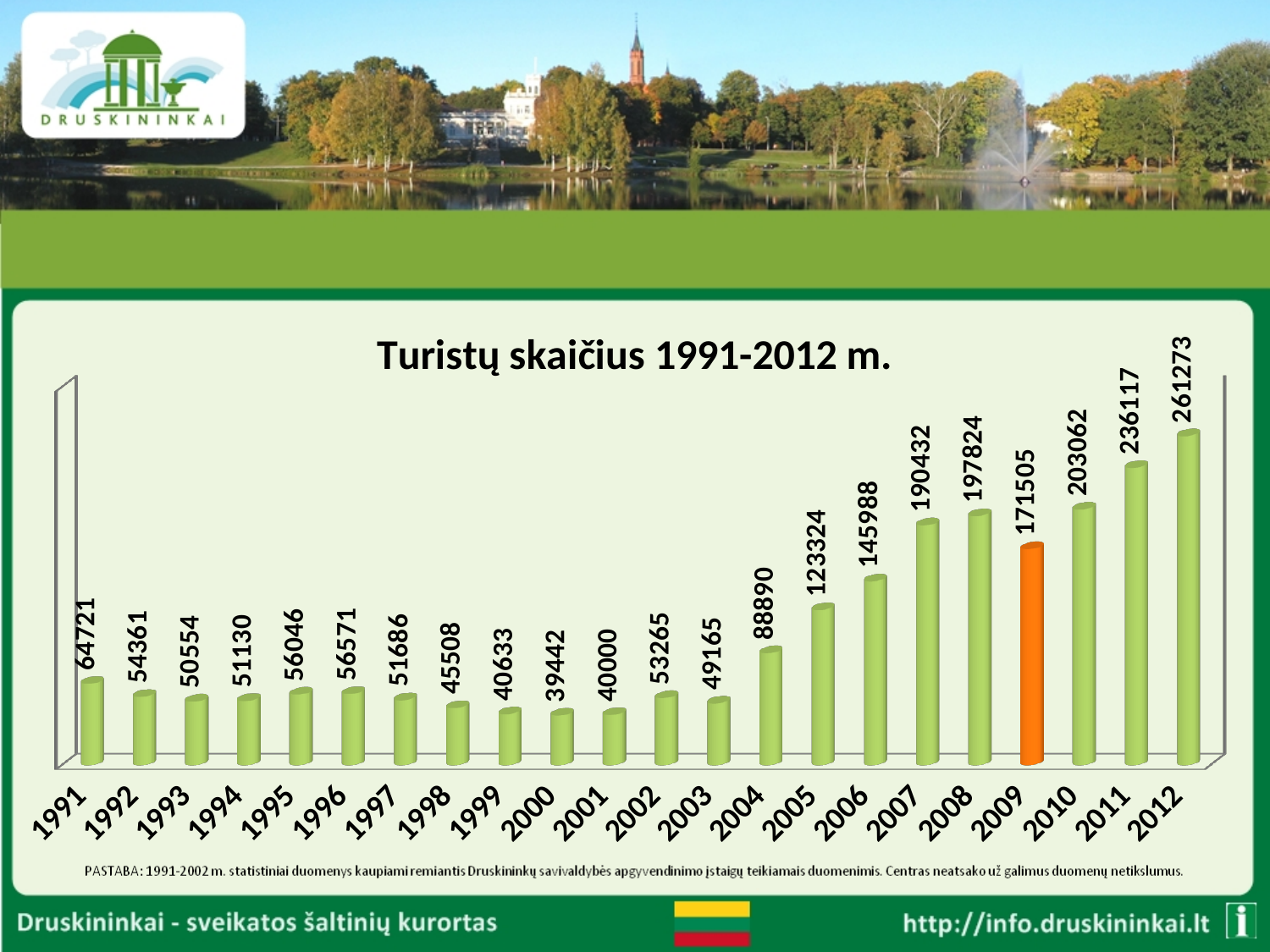
What is the difference between the values for 2008 and 2009? 26319 What is the value for 2009? 171505 Which year has the highest value? 2012 Which is larger, the value for 2007 or the value for 2010? 2010 Which bar is coloured differently (orange) from the others? 2009 What kind of chart is shown on the slide? bar chart What is the difference between the values for 2012 and 2011? 25156 Which year has the lowest value? 2000 What is the value for 1991? 64721 How many years (bars) are plotted in the chart? 22 What is the value for 2005? 123324 What is the title of the chart? Turistų skaičius 1991-2012 m.